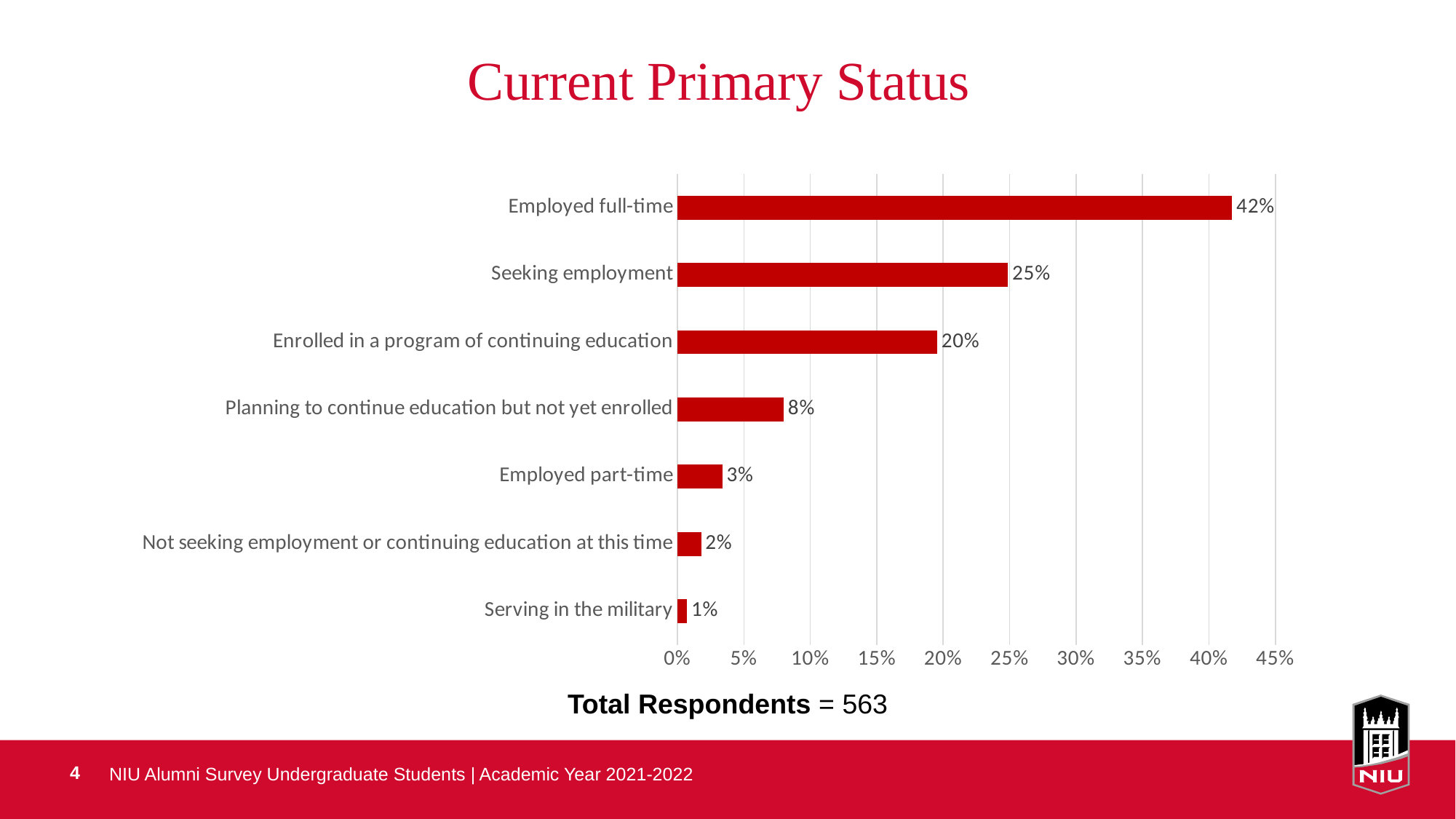
Which category has the lowest value? Serving in the military Is the value for Employed full-time greater or less than 40%? greater Which is larger, Employed part-time or Planning to continue education but not yet enrolled? Planning to continue education but not yet enrolled How many categories are shown in the chart? 7 What is the value for Serving in the military? 1% What percentage of respondents are enrolled in a program of continuing education? 20% Which category has the highest value? Employed full-time What is the total number of respondents stated below the chart? 563 What is the value for Seeking employment? 25% What percentage of respondents are employed full-time? 42% What is the difference between Employed full-time and Seeking employment? 17% What kind of chart is shown on the slide? Bar chart